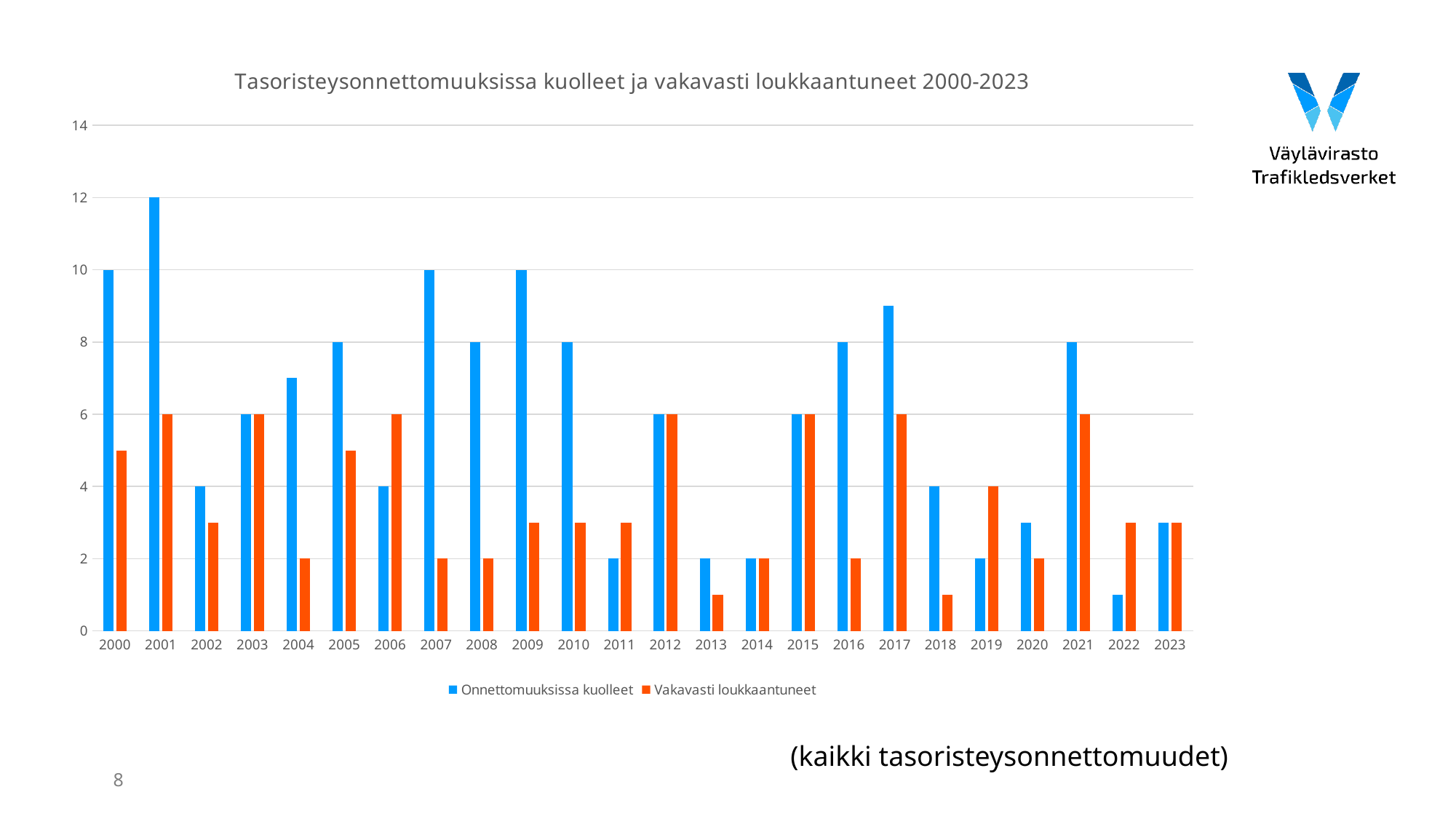
Which year has the lowest value for Onnettomuuksissa kuolleet? 2022 What is the value of Vakavasti loukkaantuneet in 2006? 6 Is the value for Onnettomuuksissa kuolleet in 2017 greater or less than 8? greater What is the title of the chart? Tasoristeysonnettomuuksissa kuolleet ja vakavasti loukkaantuneet 2000-2023 What is the value of Onnettomuuksissa kuolleet in 2009? 10 In 2019, which series has the larger value, Onnettomuuksissa kuolleet or Vakavasti loukkaantuneet? Vakavasti loukkaantuneet What type of chart is shown on the slide? Bar chart How many series does the legend list? 2 Which year has the highest value for Onnettomuuksissa kuolleet? 2001 What is the difference between Onnettomuuksissa kuolleet and Vakavasti loukkaantuneet in 2001? 6 How many years are shown on the x axis? 24 What is the value of Onnettomuuksissa kuolleet in 2001? 12